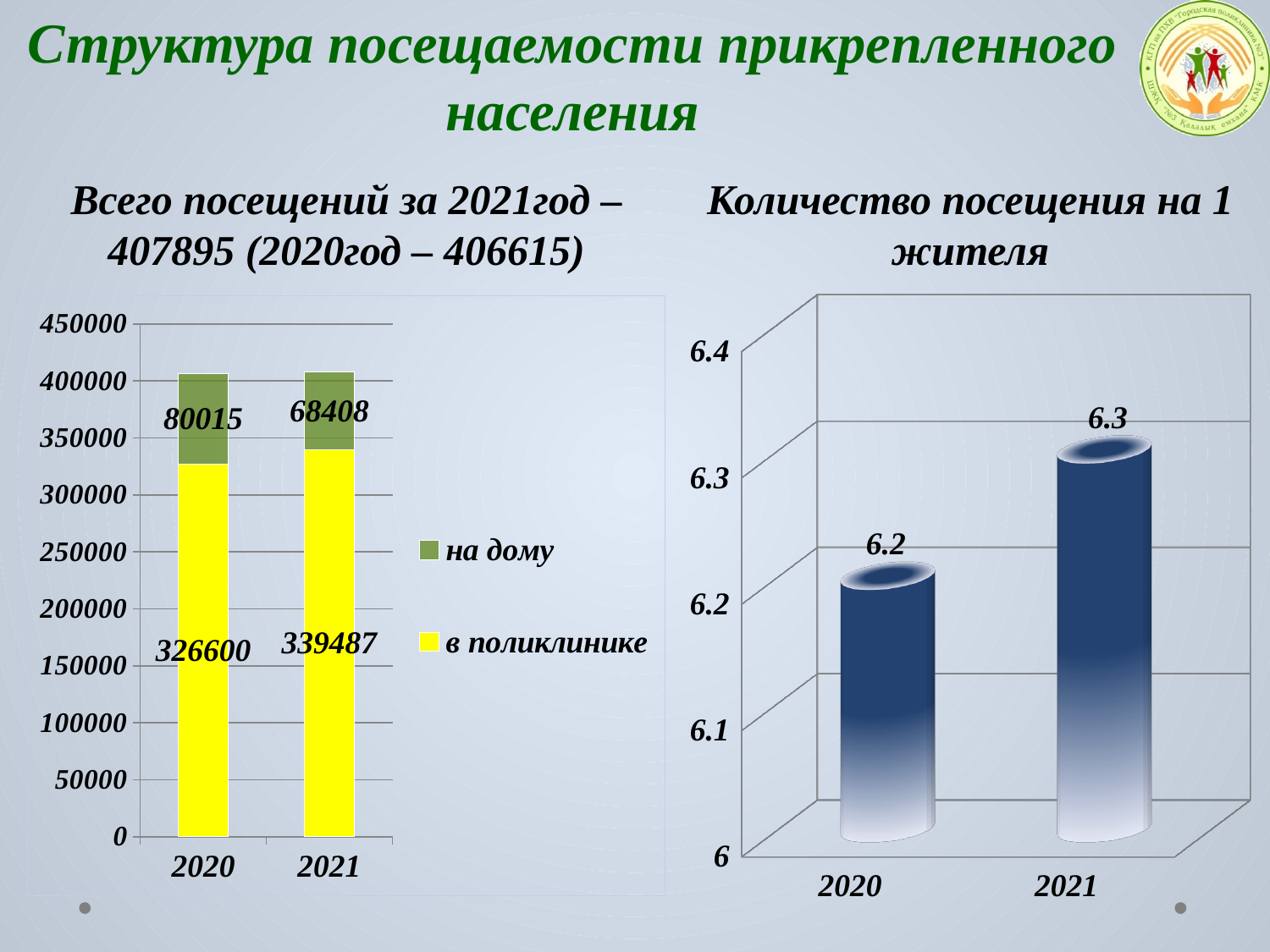
In the left chart, which year has the larger 'на дому' value, 2020 or 2021? 2020 In the left chart, what is the total of the stacked bar for 2020? 406615 In the left chart, what is the value for 'на дому' in 2021? 68408 In the chart 'Количество посещения на 1 жителя', which year has the lowest value? 2020 In the left chart, what is the value for 'на дому' in 2020? 80015 How many series does the legend of the left chart list? 2 In the left chart, which colour represents 'в поликлинике'? Yellow In the left chart, what is the total of the stacked bar for 2021? 407895 In the chart 'Количество посещения на 1 жителя', what is the value for 2021? 6.3 In the left chart, what is the difference between the 'в поликлинике' values for 2021 and 2020? 12887 In the left chart, what is the value for 'в поликлинике' in 2020? 326600 In the chart 'Количество посещения на 1 жителя', do the values rise or fall from 2020 to 2021? Rise